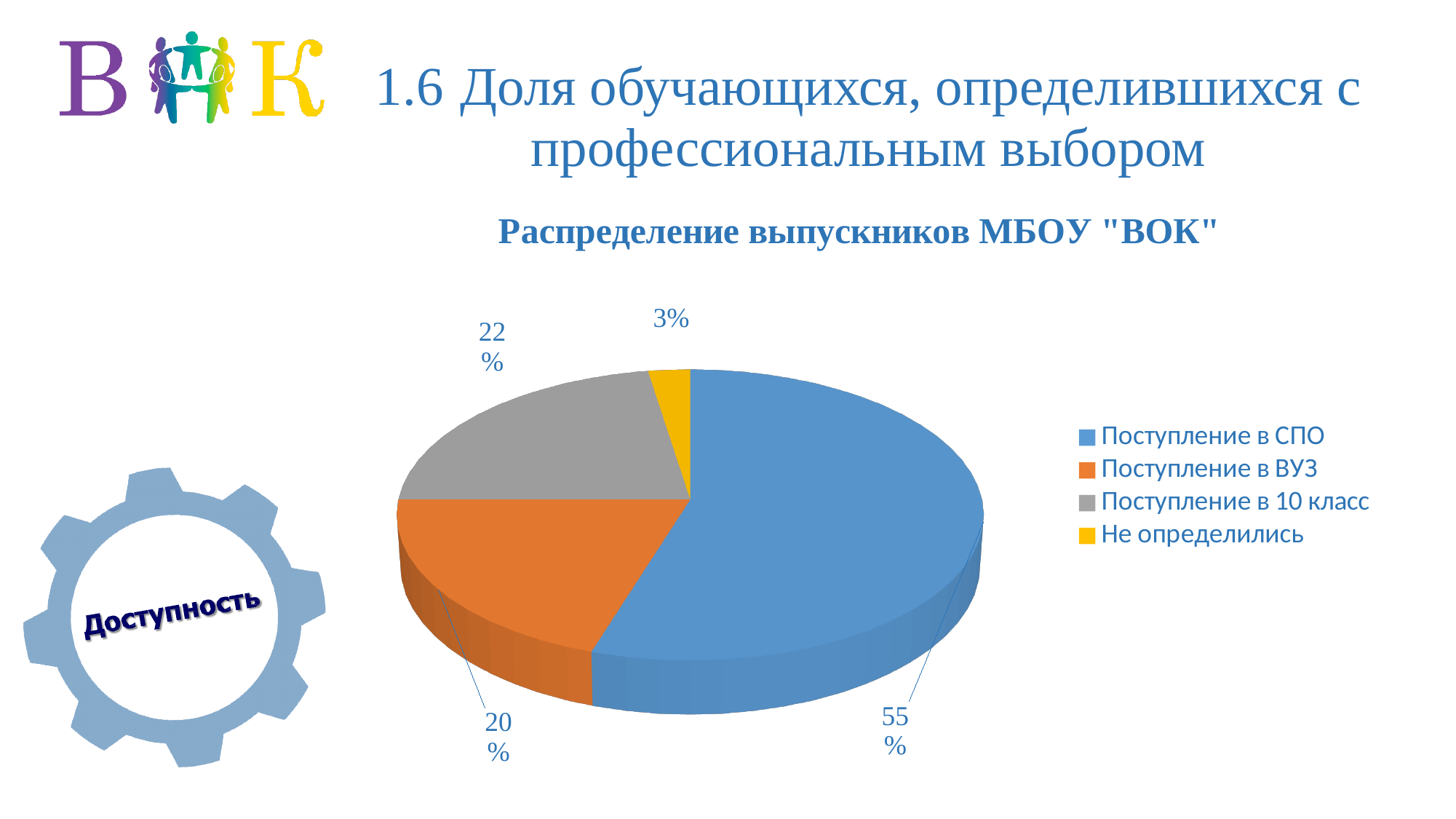
What kind of chart is shown on the slide? Pie chart How many categories does the pie chart show? 4 What share of the pie is "Не определились"? 3% Which is larger, the share for "Поступление в 10 класс" or the share for "Поступление в ВУЗ"? Поступление в 10 класс What share of the pie is "Поступление в 10 класс"? 22% Which colour represents "Не определились" in the legend? Yellow What is the difference between the shares for "Поступление в СПО" and "Поступление в ВУЗ"? 35% What is the title of the chart? Распределение выпускников МБОУ "ВОК" What share of the pie is "Поступление в ВУЗ"? 20% Which category has the smallest slice of the pie? Не определились Which category has the largest slice of the pie? Поступление в СПО